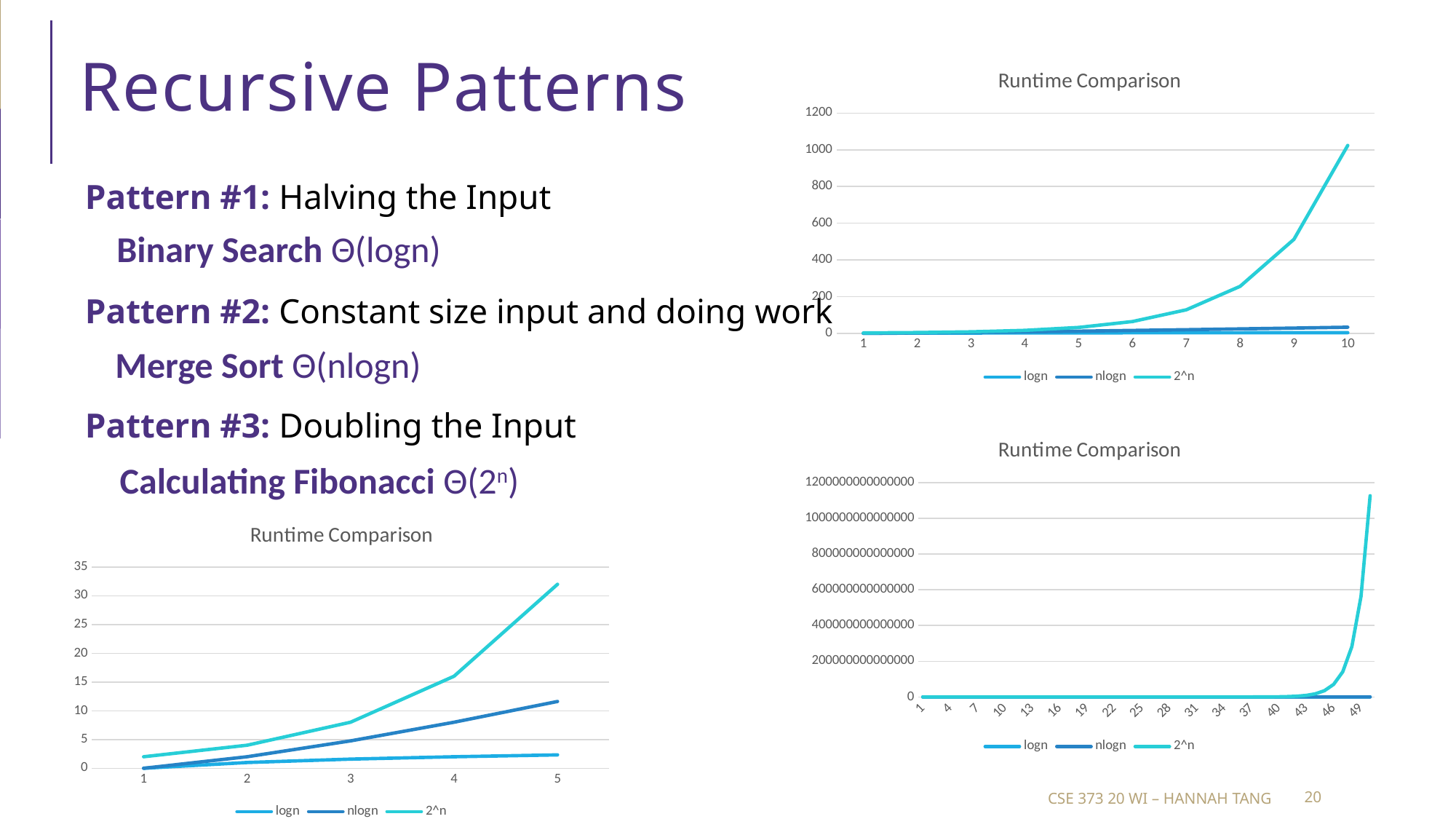
In the bottom-left chart, which series has the highest value at x = 5? 2^n How many x-axis categories does the top-right chart show? 10 How many x-axis categories does the bottom-left chart show? 5 In the bottom-left chart, is the value of 2^n at x = 5 greater or less than 30? greater What kind of chart is the bottom-left chart? line chart In the bottom-left chart, which series has the lowest value at x = 5? logn What is the title of the bottom-right chart? Runtime Comparison In the bottom-left chart, which is larger at x = 5: nlogn or logn? nlogn In the top-right chart, is the value of 2^n at x = 10 greater or less than 800? greater In the bottom-left chart, is the value of 2^n at x = 4 greater or less than 20? less How many series does the legend of the top-right chart list? 3 In the bottom-left chart, does the 2^n series rise or fall as x increases? rise